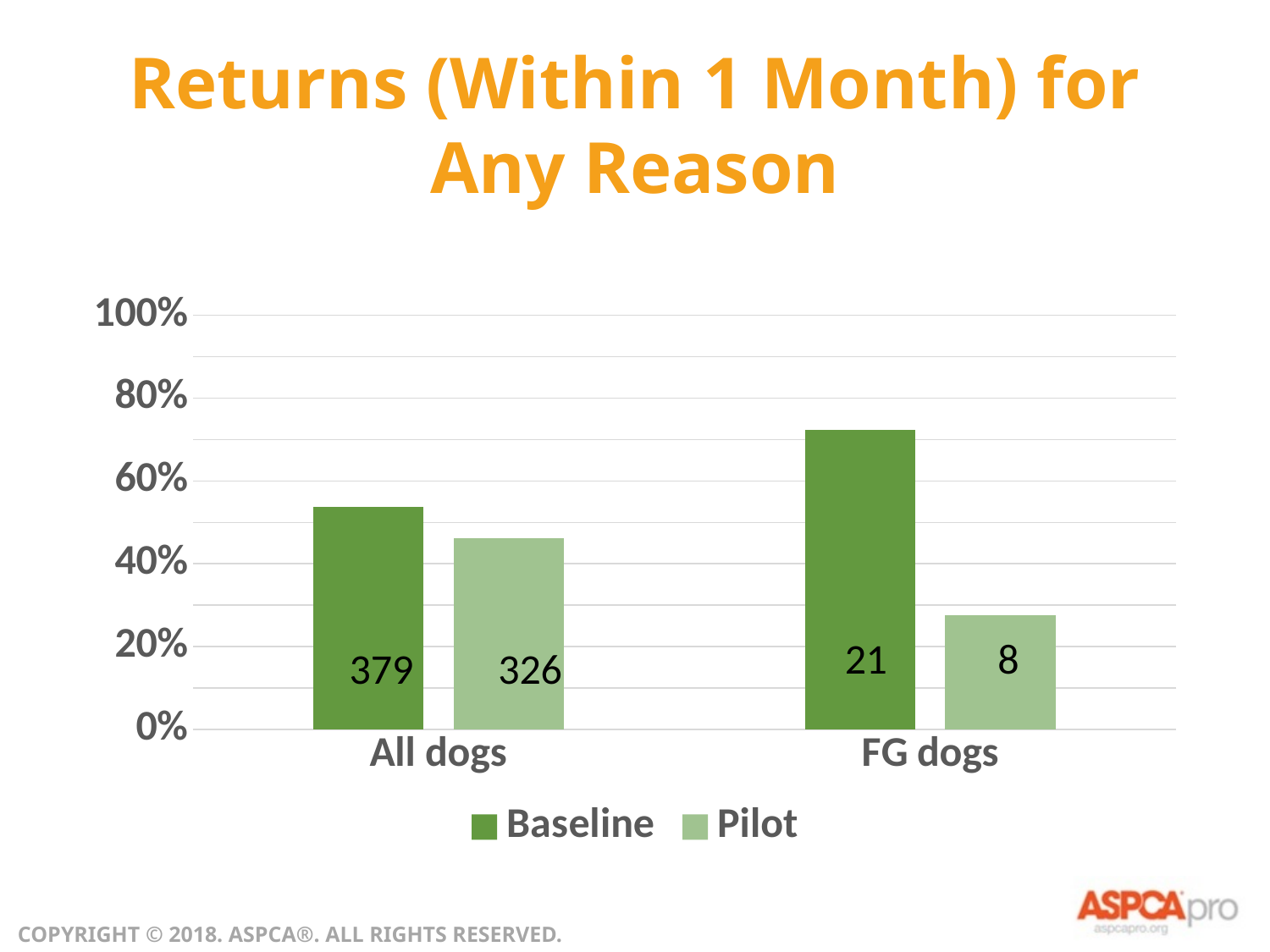
What kind of chart is shown on the slide? bar chart How many series does the legend list? 2 How many categories are shown on the x axis? 2 What number is printed on the Baseline bar for All dogs? 379 What is the difference between the numbers printed on the Baseline and Pilot bars for All dogs? 53 Which bar is the shortest in the chart? Pilot for FG dogs What number is printed on the Baseline bar for FG dogs? 21 Is the Baseline bar for FG dogs greater or less than 60%? greater Is the Pilot bar for FG dogs greater or less than 40%? less What number is printed on the Pilot bar for FG dogs? 8 Which bar is the tallest in the chart? Baseline for FG dogs What is the title of the chart? Returns (Within 1 Month) for Any Reason